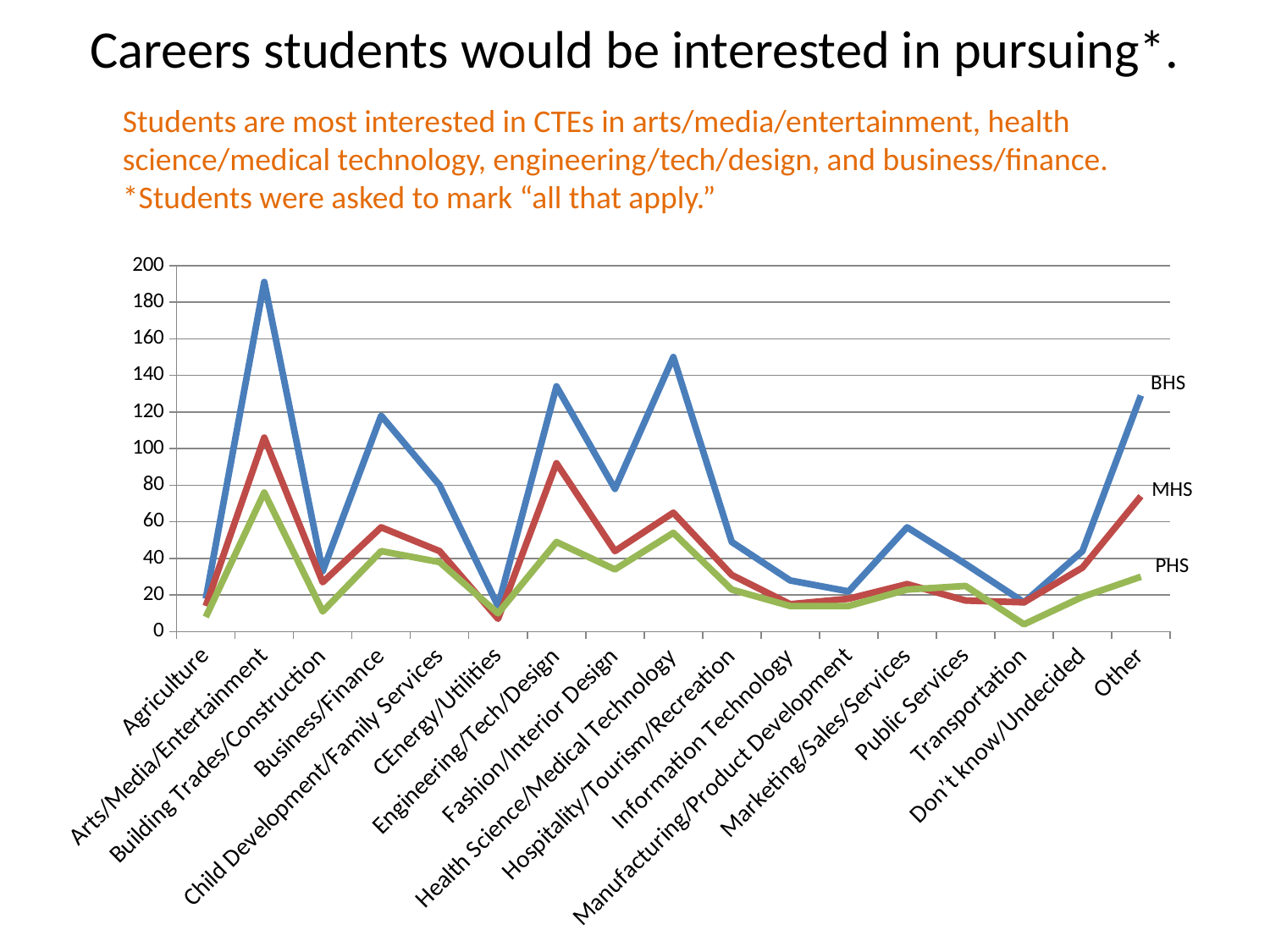
For Engineering/Tech/Design, which series has the larger value, BHS or PHS? BHS Is the PHS value for Transportation greater or less than 20? less Is the BHS value for Arts/Media/Entertainment greater or less than 180? greater How many series are plotted on the chart? 3 What kind of chart is shown on the slide? Line chart Is the BHS value for Health Science/Medical Technology greater or less than 140? greater Which career category has the highest BHS value? Arts/Media/Entertainment Which career category has the highest MHS value? Arts/Media/Entertainment Which career category has the highest PHS value? Arts/Media/Entertainment How many career categories are shown along the x axis? 17 What are the names of the three series labelled on the chart? BHS, MHS, PHS